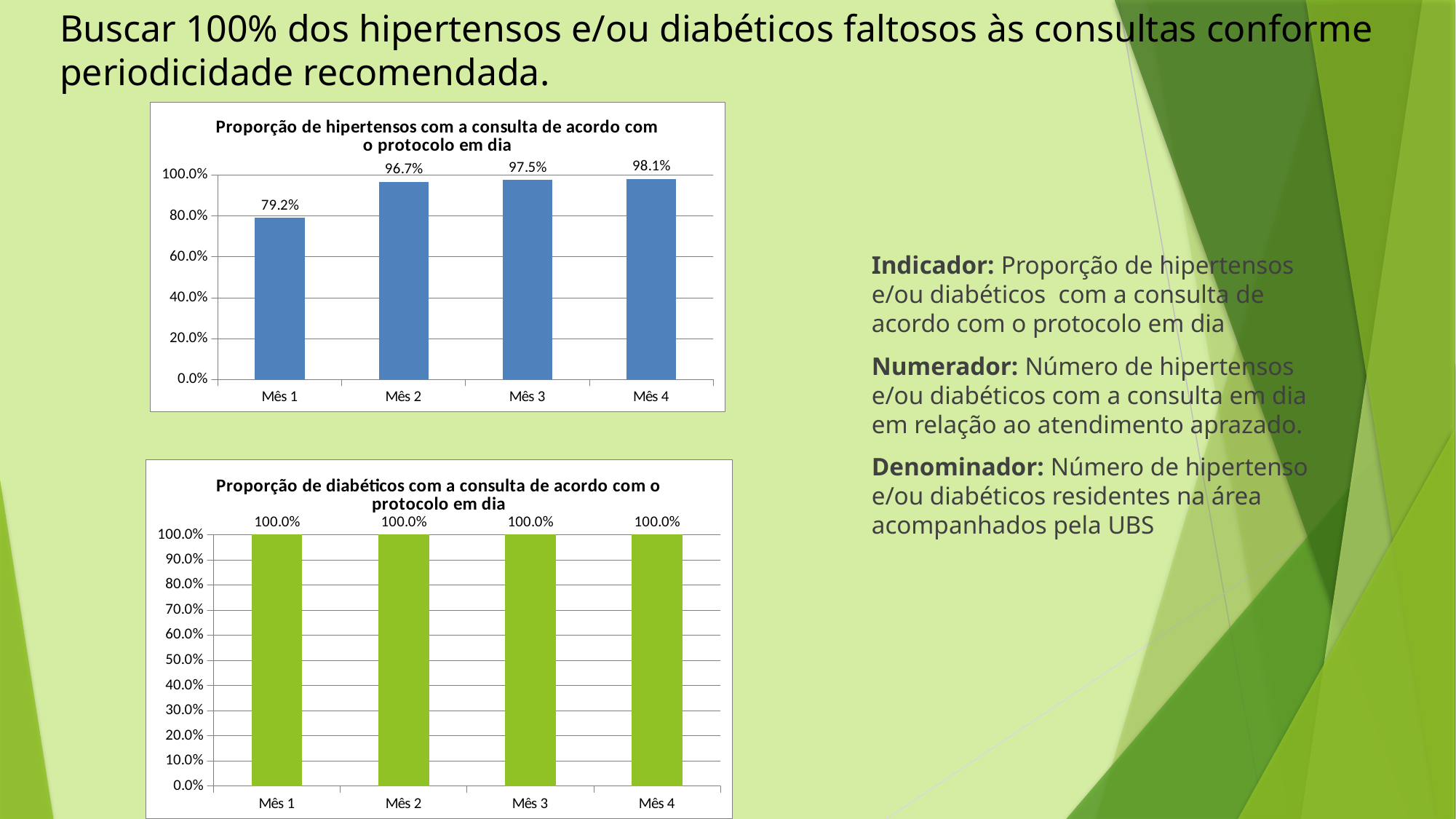
In the top chart (Proporção de hipertensos com a consulta de acordo com o protocolo em dia), what is the difference between the values for Mês 2 and Mês 1? 17.5% In the top chart (Proporção de hipertensos com a consulta de acordo com o protocolo em dia), what is the value for Mês 1? 79.2% In the top chart (Proporção de hipertensos com a consulta de acordo com o protocolo em dia), what is the value for Mês 3? 97.5% In the top chart (Proporção de hipertensos com a consulta de acordo com o protocolo em dia), do the values rise or fall from Mês 1 to Mês 4? rise In the top chart (Proporção de hipertensos com a consulta de acordo com o protocolo em dia), which month has the highest value? Mês 4 What kind of chart is the bottom chart (Proporção de diabéticos com a consulta de acordo com o protocolo em dia)? bar chart In the top chart (Proporção de hipertensos com a consulta de acordo com o protocolo em dia), is the value for Mês 1 greater or less than 80.0%? less In the top chart (Proporção de hipertensos com a consulta de acordo com o protocolo em dia), which month has the lowest value? Mês 1 In the bottom chart (Proporção de diabéticos com a consulta de acordo com o protocolo em dia), how many months are shown on the x axis? 4 What colour are the bars in the bottom chart (Proporção de diabéticos com a consulta de acordo com o protocolo em dia)? green Which is larger: the value for Mês 4 in the top chart (hipertensos) or the value for Mês 4 in the bottom chart (diabéticos)? Mês 4 in the bottom chart (diabéticos) In the bottom chart (Proporção de diabéticos com a consulta de acordo com o protocolo em dia), what is the value for Mês 2? 100.0%